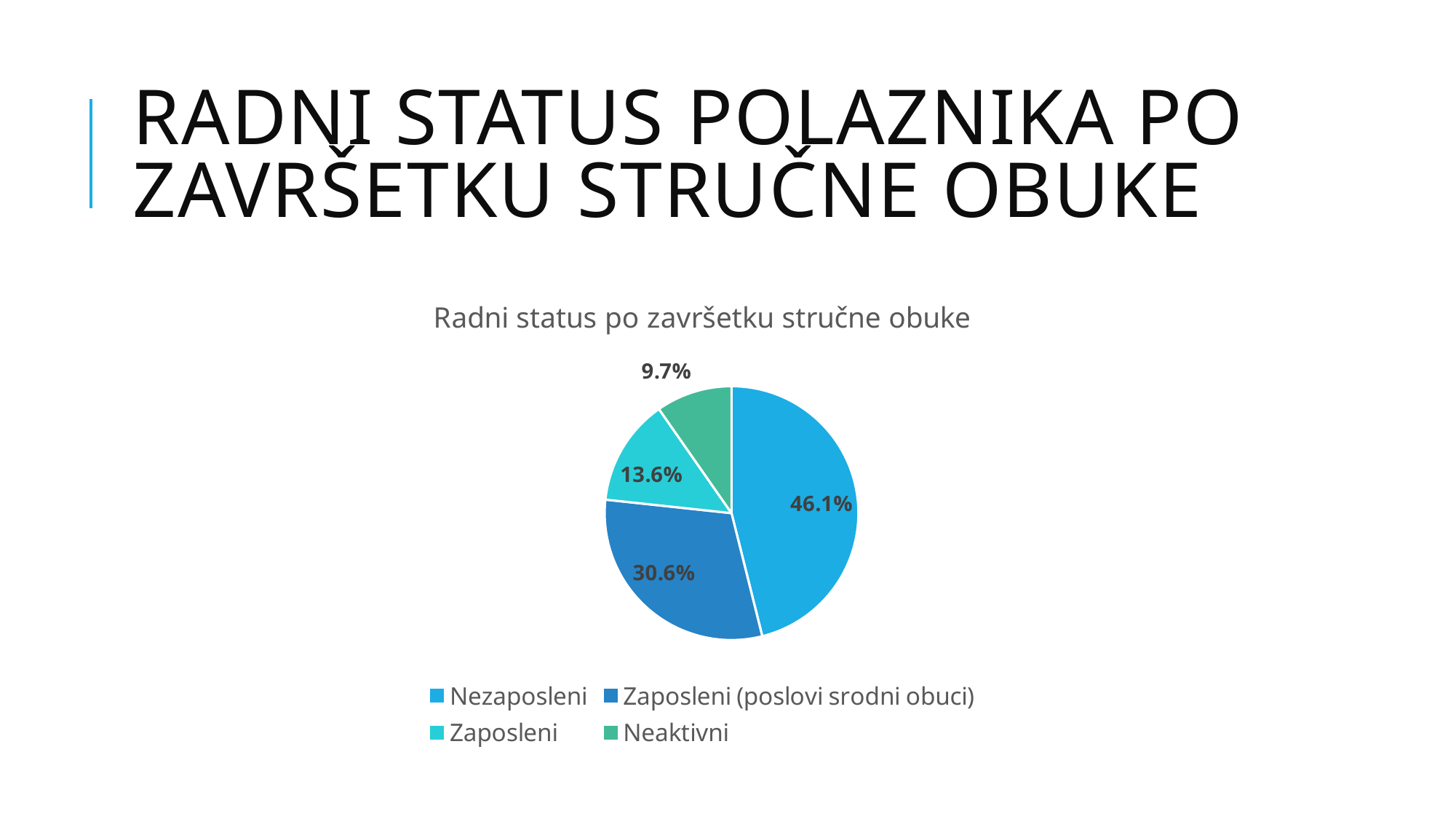
How many categories does the pie chart have? 4 Which category has the largest slice? Nezaposleni What share of the pie is Zaposleni? 13.6% What share of the pie is Neaktivni? 9.7% What share of the pie is Zaposleni (poslovi srodni obuci)? 30.6% Which category has the smallest slice? Neaktivni What share of the pie is Nezaposleni? 46.1% What is the difference in percentage points between Nezaposleni and Zaposleni (poslovi srodni obuci)? 15.5 Which is larger, Zaposleni or Neaktivni? Zaposleni What is the chart's title? Radni status po završetku stručne obuke What kind of chart is shown on the slide? pie chart What is the difference in percentage points between Zaposleni and Neaktivni? 3.9